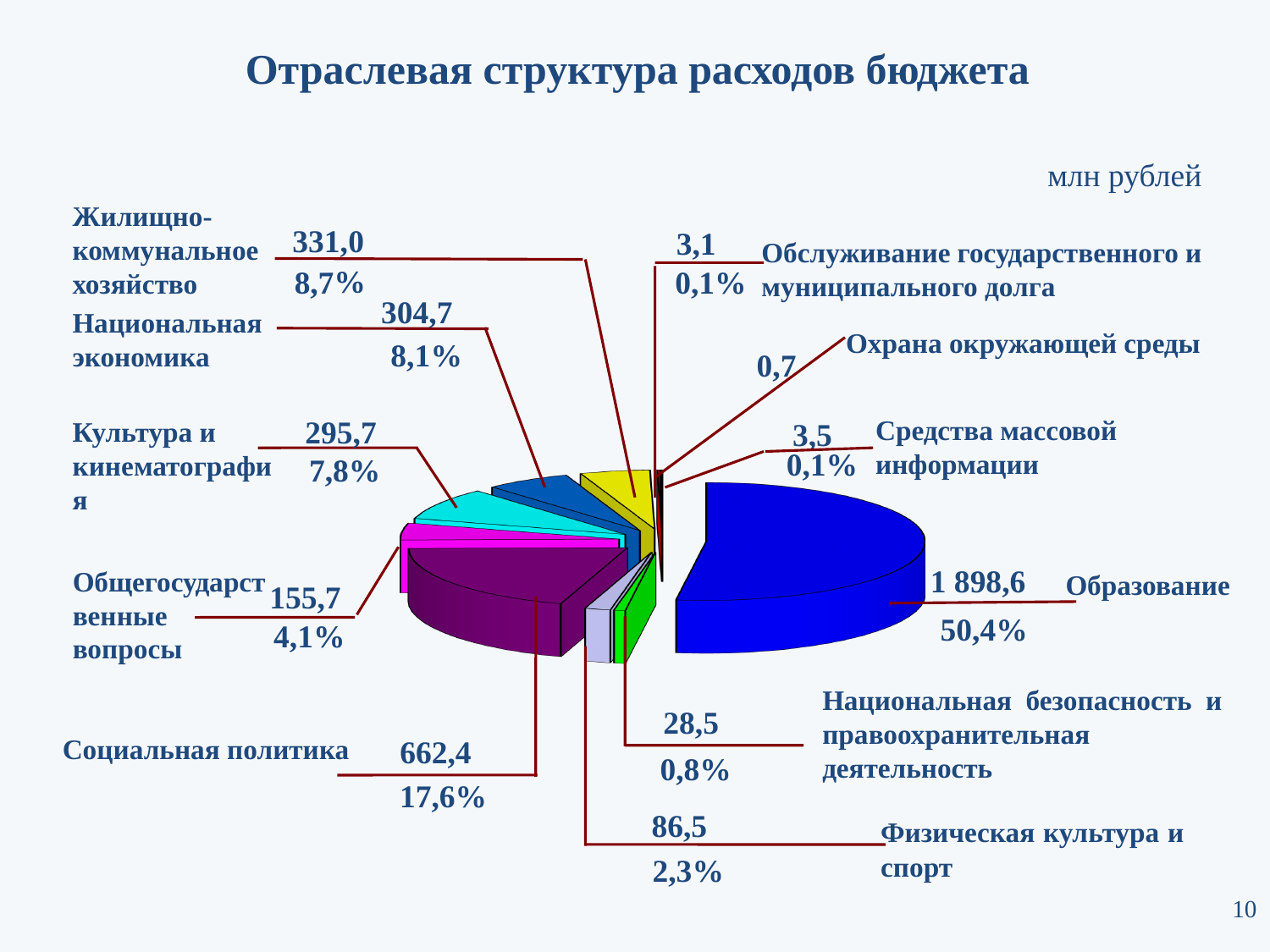
What share of the pie does Образование take? 50,4% What unit is stated for the values on the chart? млн рублей What is the value for Охрана окружающей среды? 0,7 What percentage is shown for Жилищно-коммунальное хозяйство? 8,7% Which category has the largest value? Образование What kind of chart is shown on the slide? pie chart Which is larger, the value for Культура и кинематография or the value for Общегосударственные вопросы? Культура и кинематография How many categories are shown in the pie chart? 11 Which category has the smallest value? Охрана окружающей среды What is the difference between the values for Жилищно-коммунальное хозяйство and Национальная экономика? 26,3 What is the value for Образование? 1 898,6 What is the value for Социальная политика? 662,4